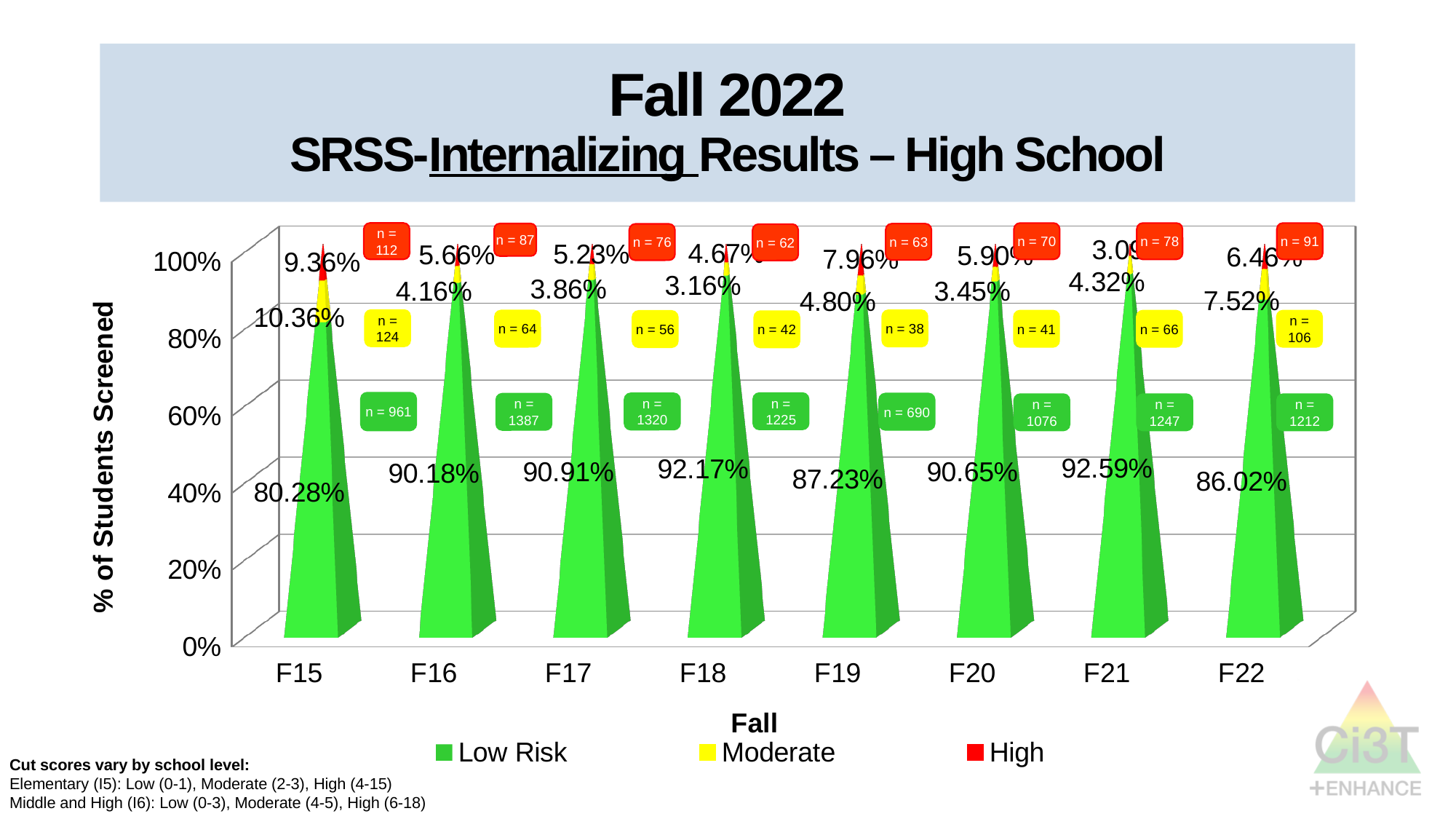
What is the Low Risk percentage for F18? 92.17% How many fall semesters are shown on the x axis? 8 What kind of chart is shown on the slide? Stacked bar chart What is the High percentage for F19? 7.96% Which fall has the lowest Low Risk percentage? F15 What is the difference between the Low Risk percentages for F16 and F15? 9.90 percentage points Is the Low Risk value for F19 greater or less than 80%? greater Which has a larger Moderate percentage, F22 or F19? F22 Which fall has the highest Low Risk percentage? F21 Which fall has the highest Moderate percentage? F15 What is the Moderate percentage for F15? 10.36% How many series does the legend list? 3